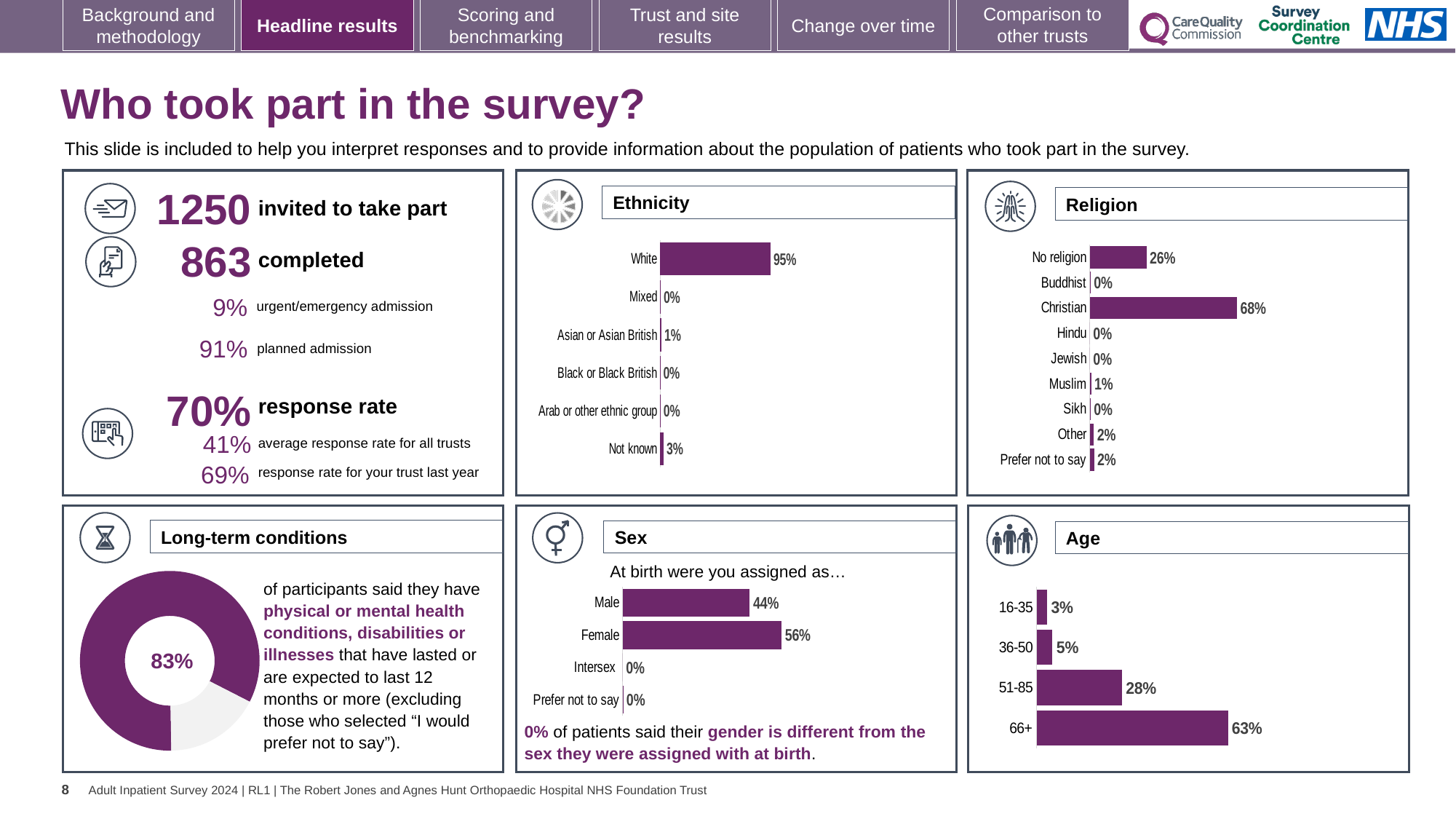
In the Age chart, what is the value for 51-85? 28% In the Sex chart, what is the difference between the Female and Male percentages? 12% What kind of chart is the Age chart? Bar chart In the Sex chart, which is larger, Male or Female? Female In the Age chart, which age group has the highest value? 66+ How many categories are shown in the Ethnicity chart? 6 In the Age chart, do the values rise or fall from the 16-35 group to the 66+ group? Rise In the Long-term conditions chart, what share of participants said they have physical or mental health conditions, disabilities or illnesses? 83% In the Religion chart, which category has the highest value? Christian In the Religion chart, what is the value for No religion? 26% In the Ethnicity chart, what percentage of respondents are White? 95% How many categories are shown in the Religion chart? 9